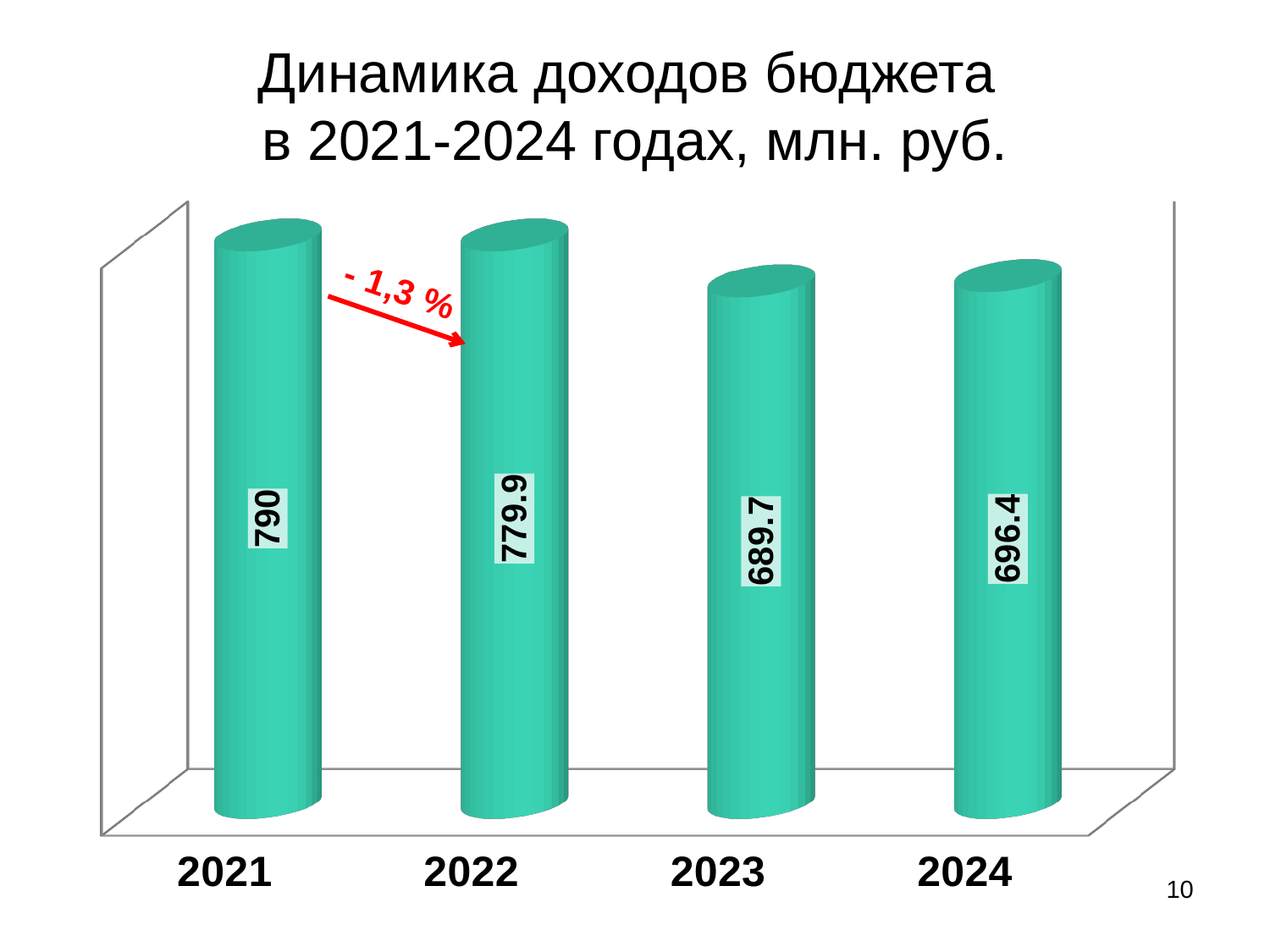
What is the budget revenue value shown for 2024? 696.4 Do the values rise or fall from 2021 to 2023? fall What kind of chart is shown on the slide? bar chart What is the budget revenue value shown for 2022? 779.9 What is the difference between the values for 2021 and 2022? 10.1 Which year has the lowest budget revenue value? 2023 Which is larger, the value for 2023 or the value for 2024? 2024 Which year has the highest budget revenue value? 2021 What is the budget revenue value shown for 2023? 689.7 How many years are shown on the chart? 4 What is the difference between the values for 2024 and 2023? 6.7 What is the budget revenue value shown for 2021? 790